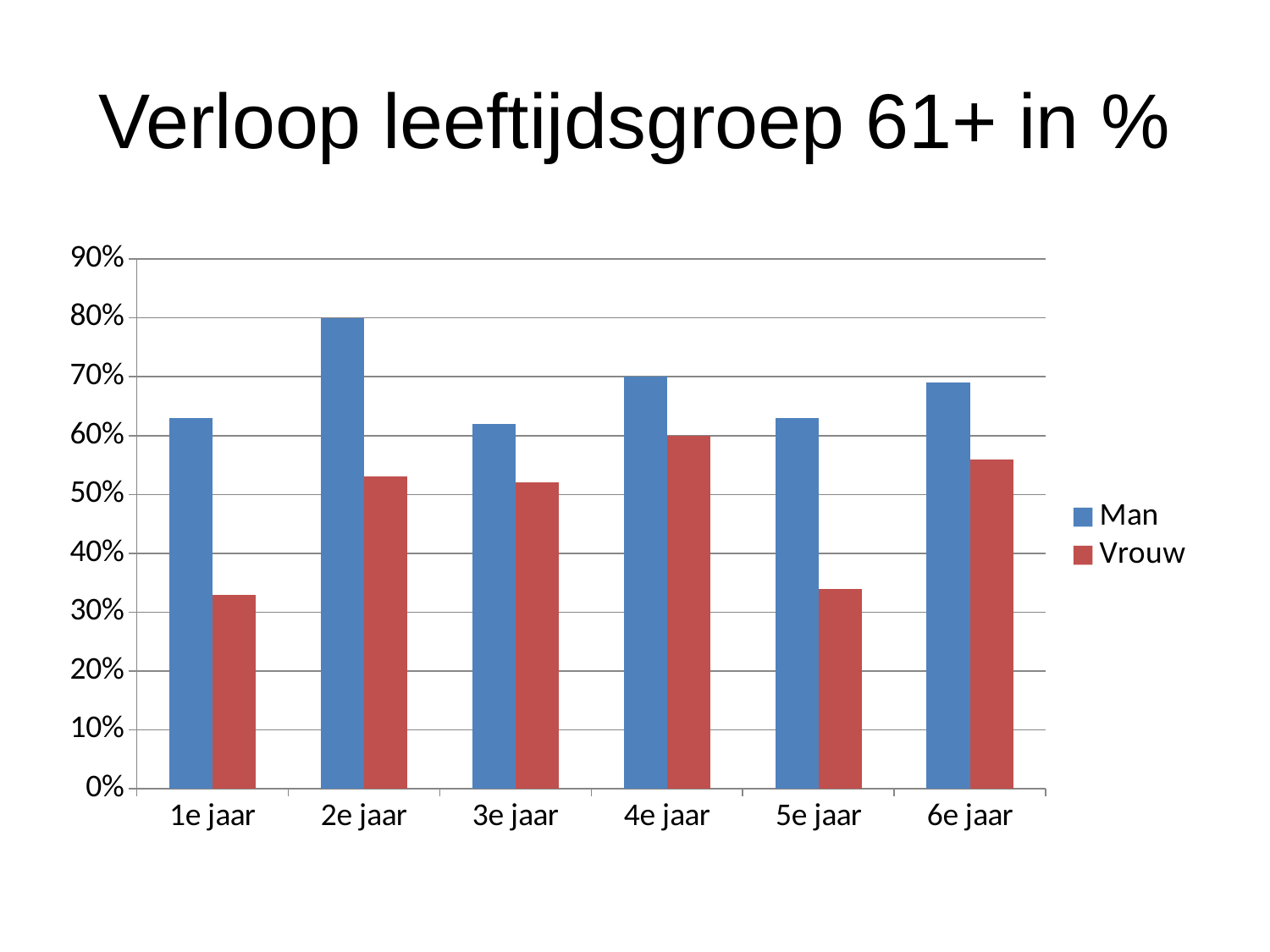
How many series does the legend list? 2 In 1e jaar, which is larger, Man or Vrouw? Man Is the value for Vrouw in 1e jaar greater or less than 40%? less In which year is the Man value highest? 2e jaar What is the title of the chart? Verloop leeftijdsgroep 61+ in % What is the value for Vrouw in 4e jaar? 60% What is the value for Man in 2e jaar? 80% How many year categories are shown on the x axis? 6 What kind of chart is shown on the slide? bar chart In which year is the Vrouw value highest? 4e jaar What is the value for Man in 4e jaar? 70% Is the value for Man in 6e jaar greater or less than 60%? greater